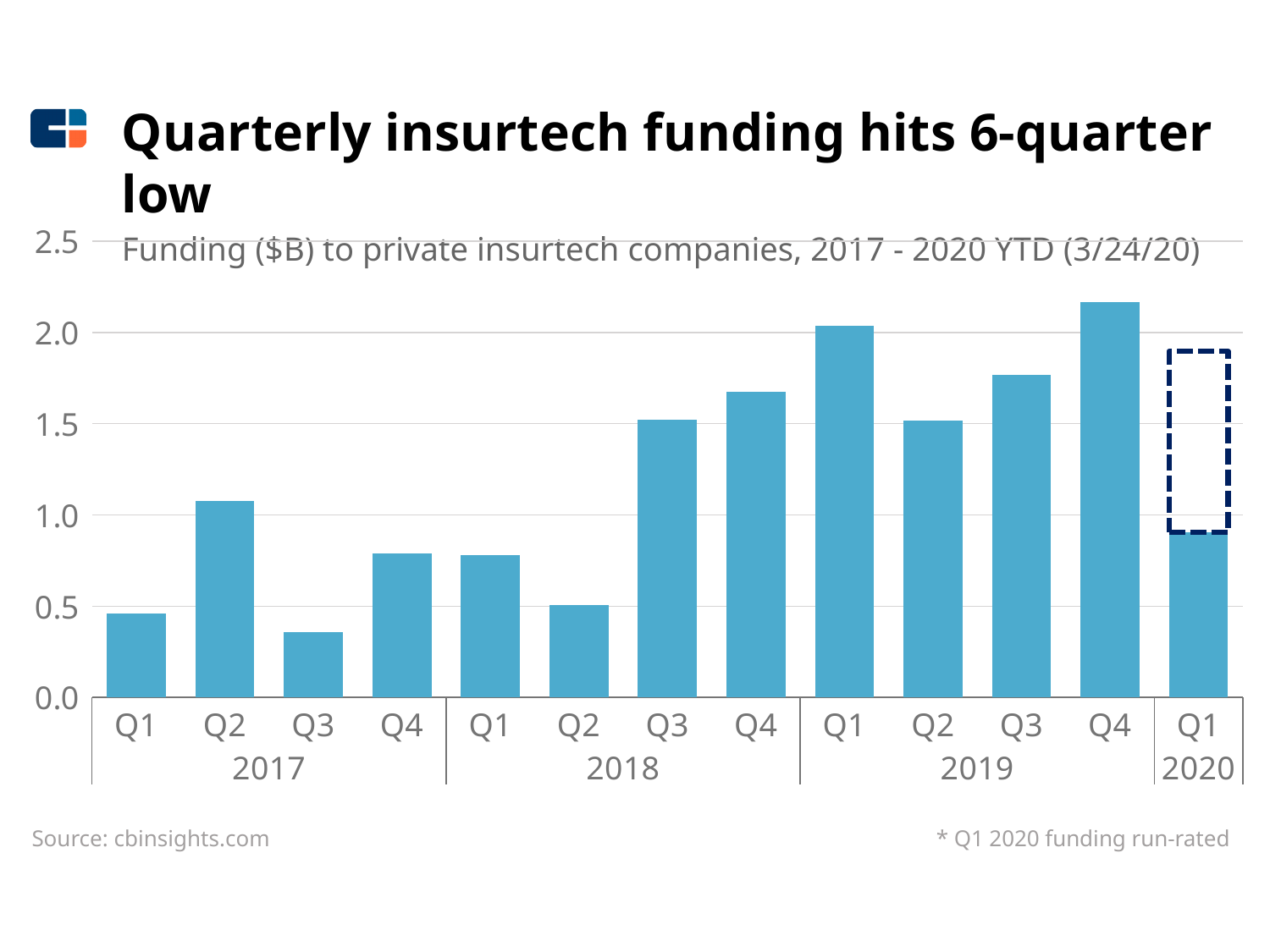
Is the funding value for Q4 2019 greater or less than 2.0? greater Is the solid bar for Q1 2020 greater or less than 1.0? less What kind of chart is shown on the slide? bar chart Which is larger, the funding value for Q1 2019 or Q4 2019? Q4 2019 Is the funding value for Q4 2018 greater or less than 1.5? greater Do the funding values rise or fall from Q2 2018 to Q1 2019? rise Which is larger, the funding value for Q2 2019 or Q3 2019? Q3 2019 Which quarter has the lowest funding value? Q3 2017 How many quarterly bars are plotted on the chart? 13 Which quarter has the highest funding value? Q4 2019 What is the title of the chart? Quarterly insurtech funding hits 6-quarter low